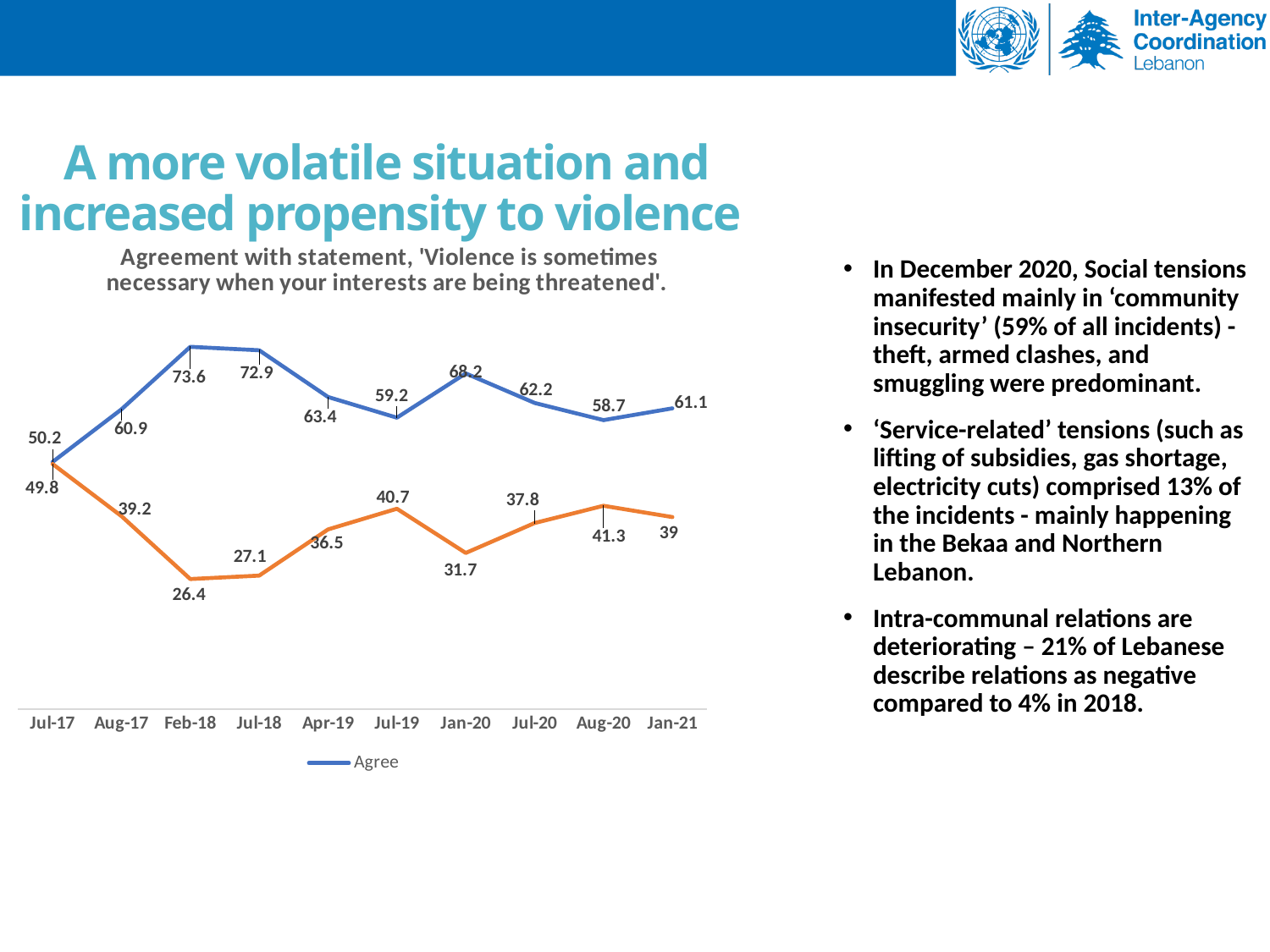
At which date does the Agree series reach its highest value? Feb-18 What is the difference between the Agree values for Feb-18 and Jul-17? 23.4 How many dates are shown on the x axis of the chart? 10 What type of chart is shown on the slide? Line chart How many series does the chart legend list? 1 Which is larger for Jan-20: the Agree value or the orange line value? Agree At which date does the Agree series have its lowest value? Jul-17 What is the value of the Agree series for Feb-18? 73.6 What is the title of the chart? Agreement with statement, 'Violence is sometimes necessary when your interests are being threatened'. What is the value of the orange line for Feb-18? 26.4 At which date does the orange line reach its lowest value? Feb-18 What is the value of the Agree series for Jan-21? 61.1